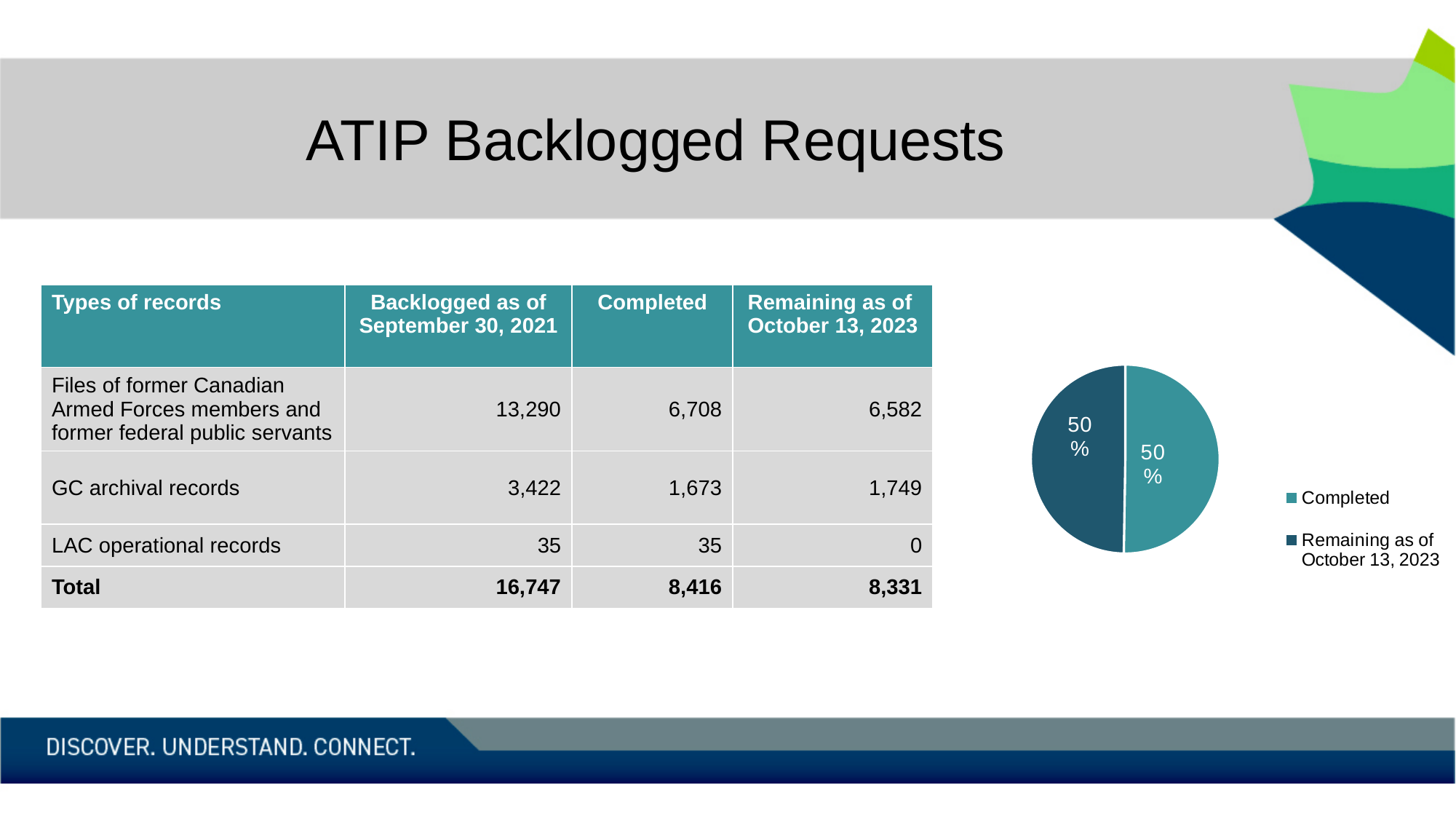
What is the first entry listed in the pie chart's legend? Completed What share of the pie chart does the Completed slice represent? 50% How many entries does the pie chart's legend list? 2 What is the data label shown on the 'Remaining as of October 13, 2023' slice of the pie chart? 50% What kind of chart is shown on the right side of the slide? pie chart What share of the pie chart does the 'Remaining as of October 13, 2023' slice represent? 50% What is the second entry listed in the pie chart's legend? Remaining as of October 13, 2023 What is the data label shown on the Completed slice of the pie chart? 50% How many slices does the pie chart have? 2